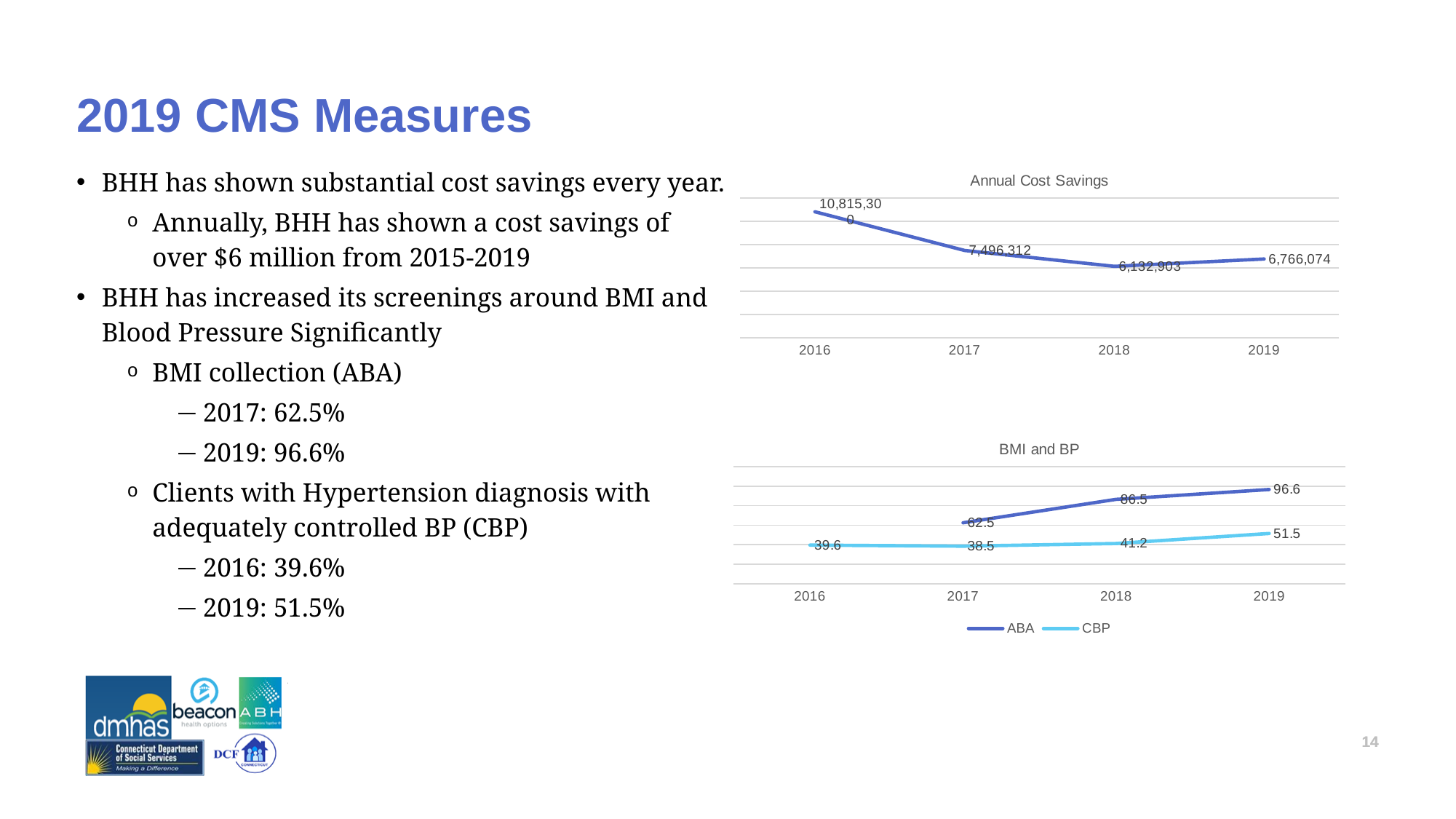
In the Annual Cost Savings chart, which year has the lowest cost savings? 2018 In the BMI and BP chart, which series has the higher value in 2019, ABA or CBP? ABA In the Annual Cost Savings chart, which year has the highest cost savings? 2016 In the BMI and BP chart, how many series does the legend list? 2 In the Annual Cost Savings chart, what is the difference between the 2019 and 2018 values? 633,171 In the BMI and BP chart, what is the difference between the ABA values for 2019 and 2017? 34.1 What kind of chart is the BMI and BP chart? Line chart In the BMI and BP chart, what is the ABA value for 2018? 86.5 In the BMI and BP chart, what is the CBP value for 2017? 38.5 In the Annual Cost Savings chart, what is the value for 2017? 7,496,312 In the Annual Cost Savings chart, what is the value for 2019? 6,766,074 In the Annual Cost Savings chart, how many years are plotted? 4